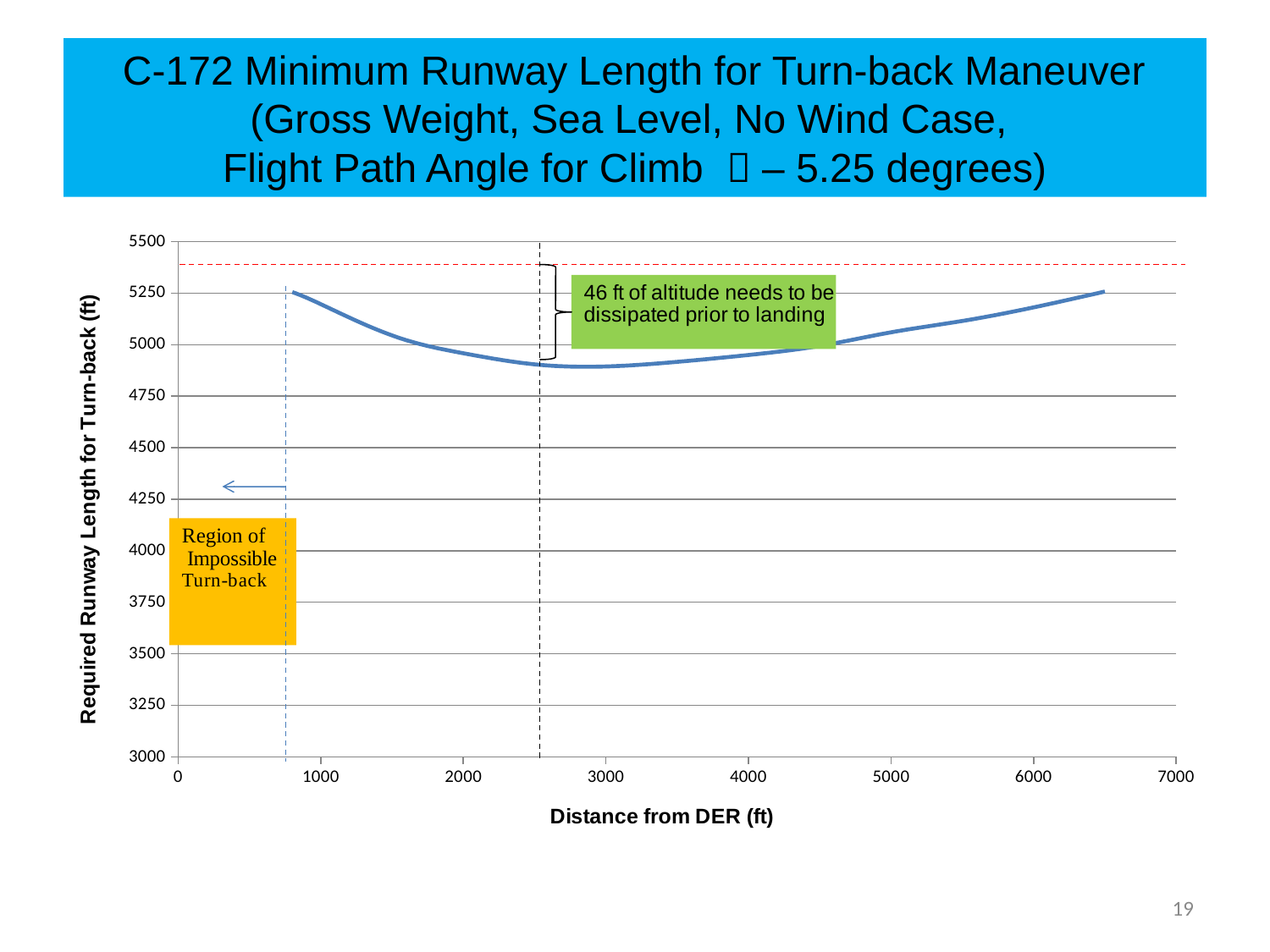
Does the required runway length rise or fall as the distance from DER increases from 3000 ft to 6500 ft? rise What is the title of the y axis? Required Runway Length for Turn-back (ft) Is the required runway length at a distance of 2000 ft from DER greater or less than 5250? less What is the highest value shown on the y axis? 5500 Is the required runway length at a distance of 6000 ft from DER greater or less than 5000? greater Is the required runway length larger at a distance of 2500 ft or at 6000 ft from DER? 6000 ft What kind of chart is shown on the slide? line chart Is the required runway length at a distance of 1000 ft from DER greater or less than 5000? greater Is the required runway length larger at a distance of 1000 ft or at 3000 ft from DER? 1000 ft What is the title of the x axis? Distance from DER (ft) Does the required runway length rise or fall as the distance from DER increases from 1000 ft to 2500 ft? fall